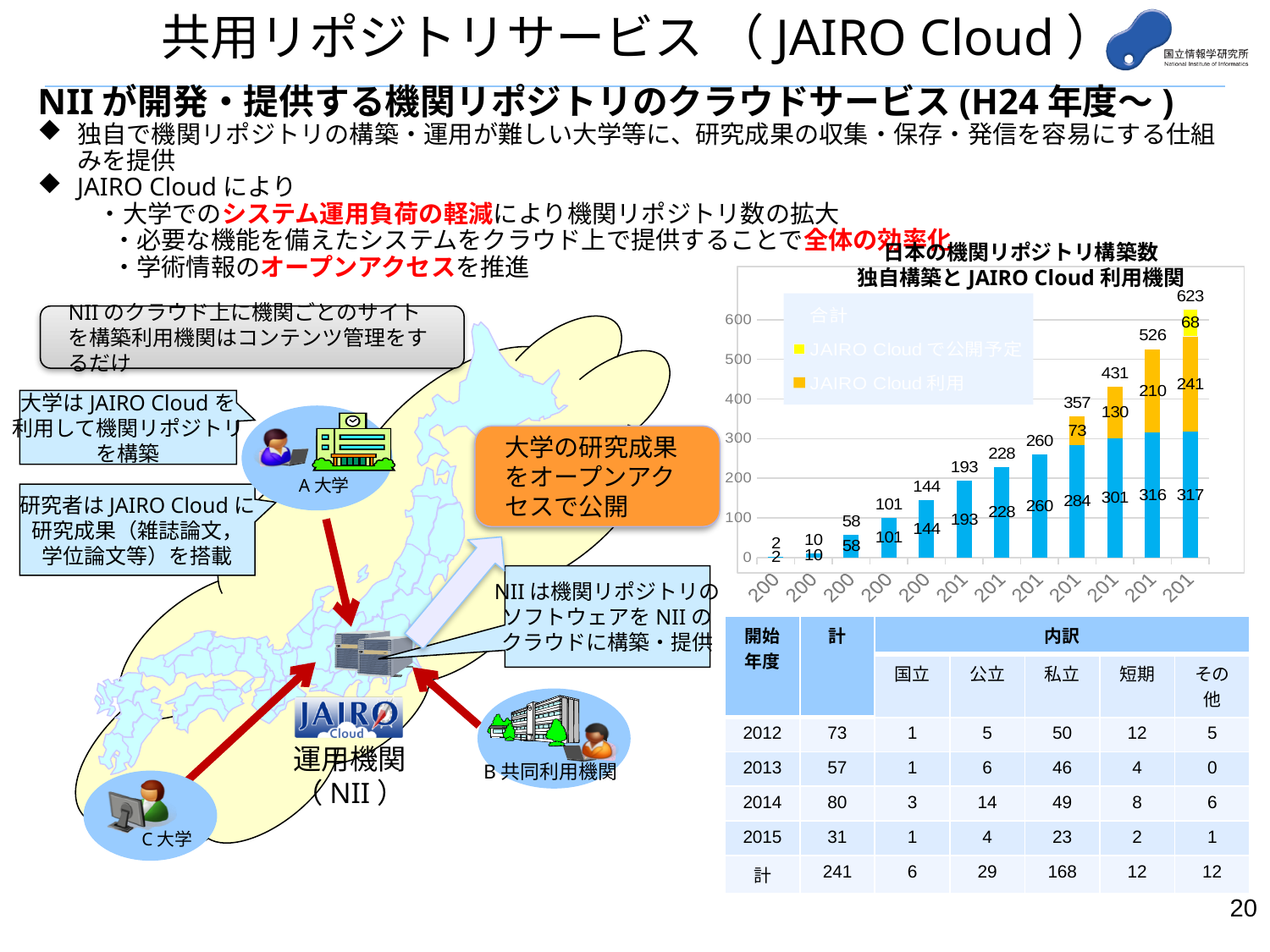
How many bars (years) are plotted in the 日本の機関リポジトリ構築数 chart? 12 In the 日本の機関リポジトリ構築数 chart, what is the JAIRO Cloud利用 (orange) value in the rightmost bar? 241 In the 日本の機関リポジトリ構築数 chart, what is the blue segment value of the rightmost bar? 317 In the 日本の機関リポジトリ構築数 chart, what is the JAIRO Cloudで公開予定 (yellow) value in the rightmost bar? 68 How many series does the legend of the 日本の機関リポジトリ構築数 chart list? 3 In the 日本の機関リポジトリ構築数 chart, which bar has the highest total? the rightmost bar What kind of chart is shown on the right side of the slide under the title 日本の機関リポジトリ構築数? stacked bar chart In the 日本の機関リポジトリ構築数 chart, what is the blue segment value of the leftmost bar? 2 In the 日本の機関リポジトリ構築数 chart, what is the difference between the JAIRO Cloud利用 values of the rightmost bar (241) and the bar just before it (210)? 31 In the 日本の機関リポジトリ構築数 chart, is the total of the second bar from the right greater or less than 500? greater In the 日本の機関リポジトリ構築数 chart, do the bar totals rise or fall from left to right? rise In the 日本の機関リポジトリ構築数 chart, what total value is labelled above the rightmost bar? 623